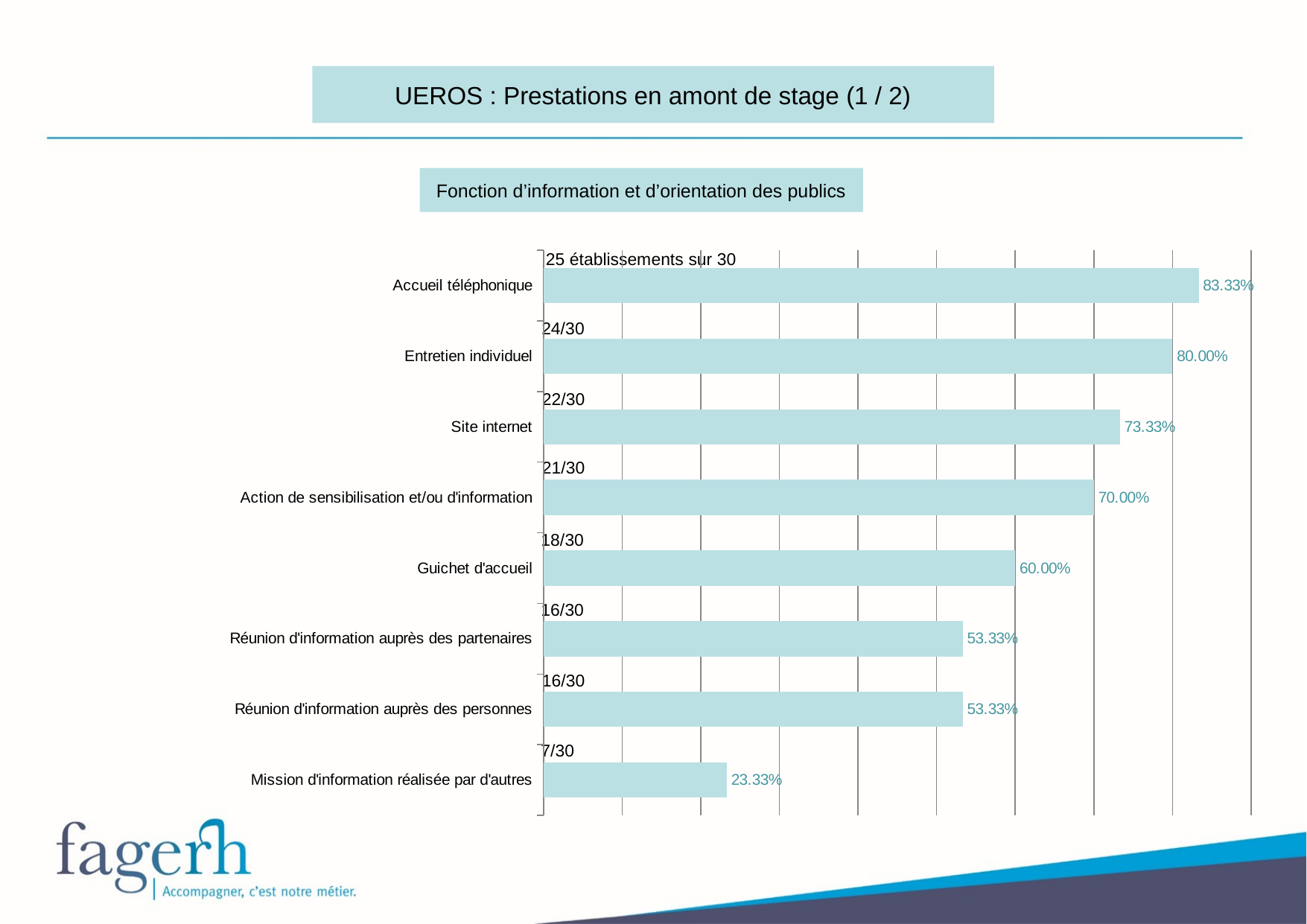
How many categories are shown in the chart? 8 What kind of chart is shown on the slide? Bar chart What is the difference in percentage points between Entretien individuel and Action de sensibilisation et/ou d'information? 10.00% Which category has the highest percentage? Accueil téléphonique Which category has the lowest percentage? Mission d'information réalisée par d'autres What percentage is shown for Guichet d'accueil? 60.00% How many establishments out of 30 are shown for Réunion d'information auprès des partenaires? 16/30 Which is larger, the value for Site internet or the value for Guichet d'accueil? Site internet How many establishments out of 30 are shown for Site internet? 22/30 What percentage is shown for Mission d'information réalisée par d'autres? 23.33% What percentage is shown for Accueil téléphonique? 83.33% What is the subtitle shown above the chart? Fonction d'information et d'orientation des publics